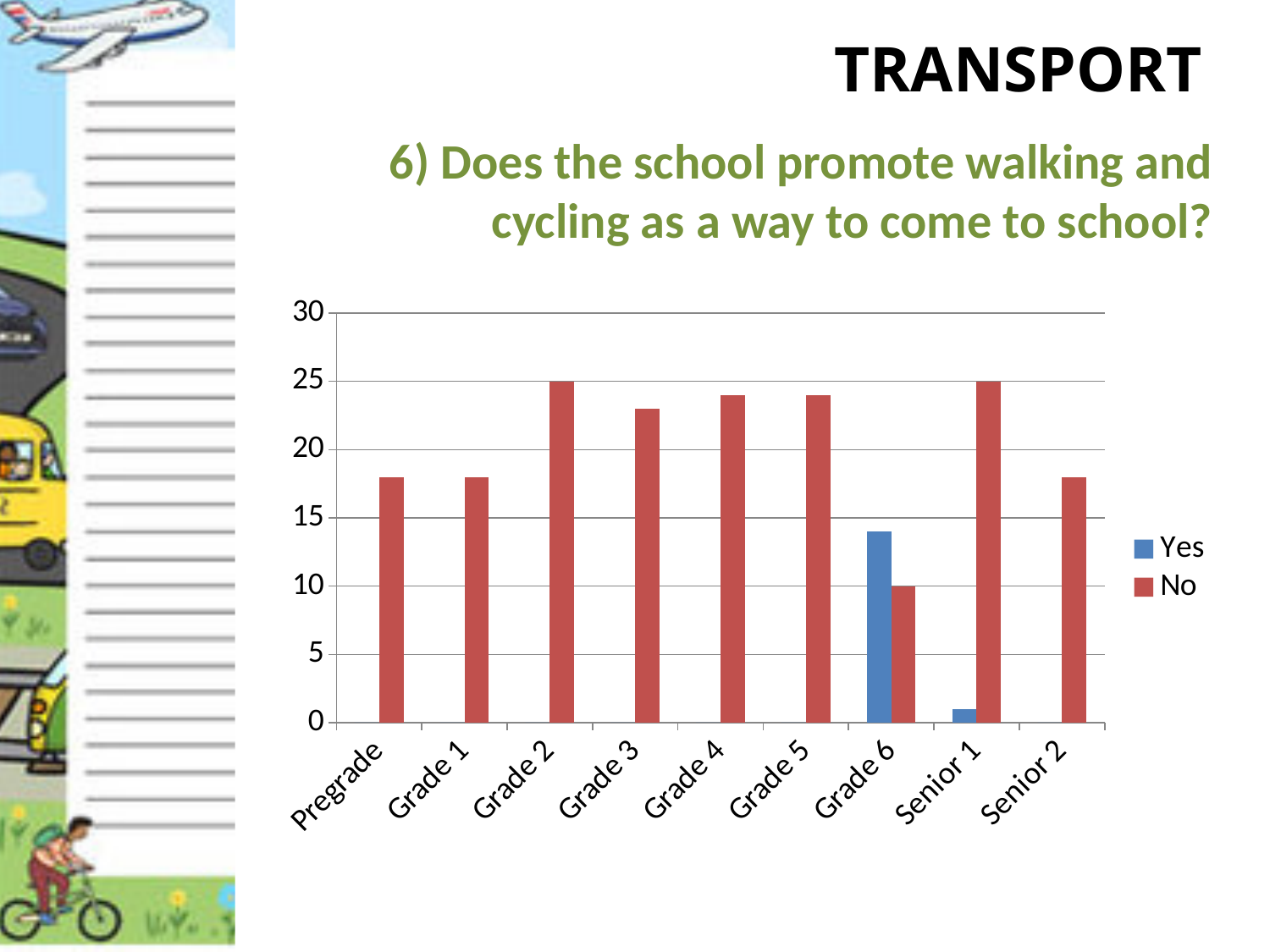
What is the 'No' value for Grade 6? 10 Is the 'Yes' value for Senior 1 greater or less than 5? less For Grade 6, which is larger, the 'Yes' value or the 'No' value? Yes What kind of chart is shown on the slide? bar chart How many series does the legend list? 2 Which category has the lowest 'No' value? Grade 6 What colour represents the 'No' series in the chart? red How many grade categories are shown on the x axis? 9 Which is larger, the 'No' value for Grade 2 or the 'No' value for Senior 2? Grade 2 Is the 'No' value for Grade 4 greater or less than 20? greater Is the 'No' value for Pregrade greater or less than 20? less What is the 'No' value for Grade 2? 25